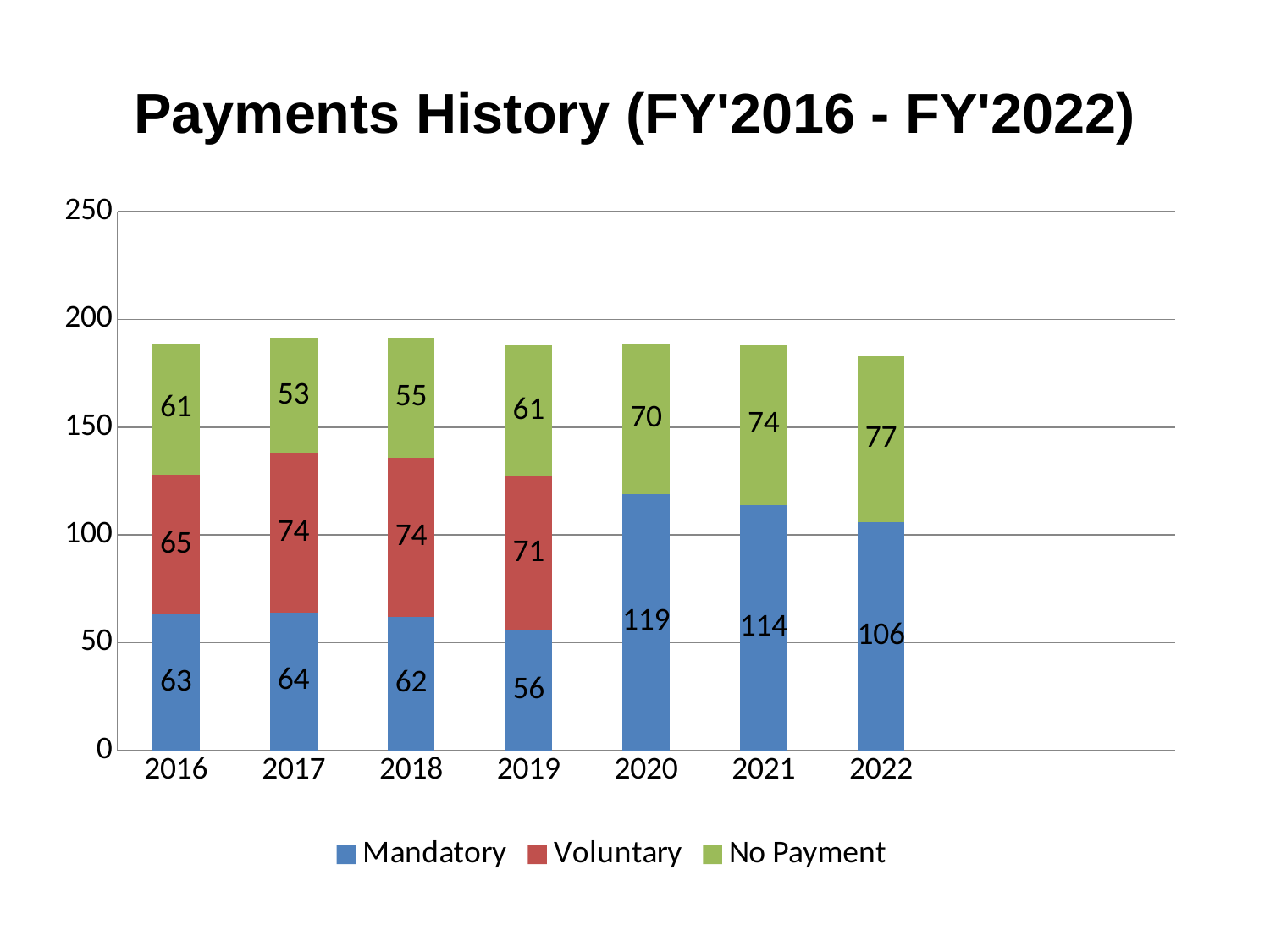
Is the Mandatory value for 2016 larger or smaller than the Mandatory value for 2017? smaller Which year has the highest No Payment value? 2022 Which year has the highest Mandatory value? 2020 What is the No Payment value for 2017? 53 What is the difference between the Mandatory values for 2020 and 2022? 13 What is the Mandatory value for 2020? 119 How many series does the legend list? 3 What is the total of the stacked bar for 2019? 188 What is the Voluntary value for 2019? 71 How many years are shown on the x axis? 7 What is the total of the stacked bar for 2016? 189 Which year has the lowest Mandatory value? 2019